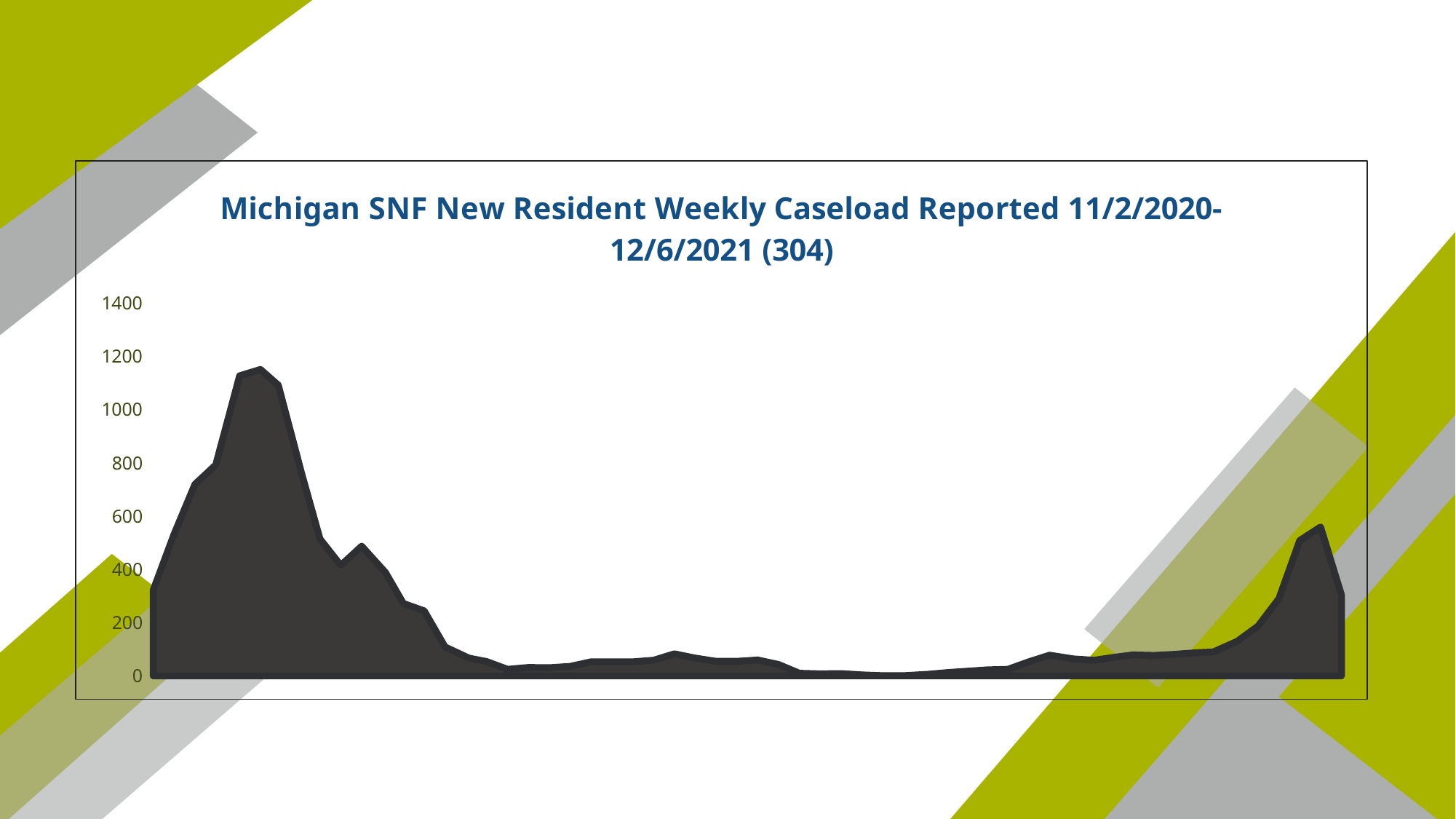
What kind of chart is shown on the slide? Area chart Which is larger: the peak near the left of the chart or the peak near the right of the chart? The peak near the left Is the value at the very start of the period (left edge of the chart) greater or less than 200? greater Is the value at the very start of the period (left edge of the chart) greater or less than 600? less Is the peak near the right end of the chart greater or less than 400? greater What is the highest tick value shown on the vertical axis? 1400 What is the title of the chart? Michigan SNF New Resident Weekly Caseload Reported 11/2/2020-12/6/2021 (304) Do the values rise or fall immediately after the first peak on the left of the chart? fall Do the values rise or fall over the final portion of the period leading up to the peak near the right edge? rise